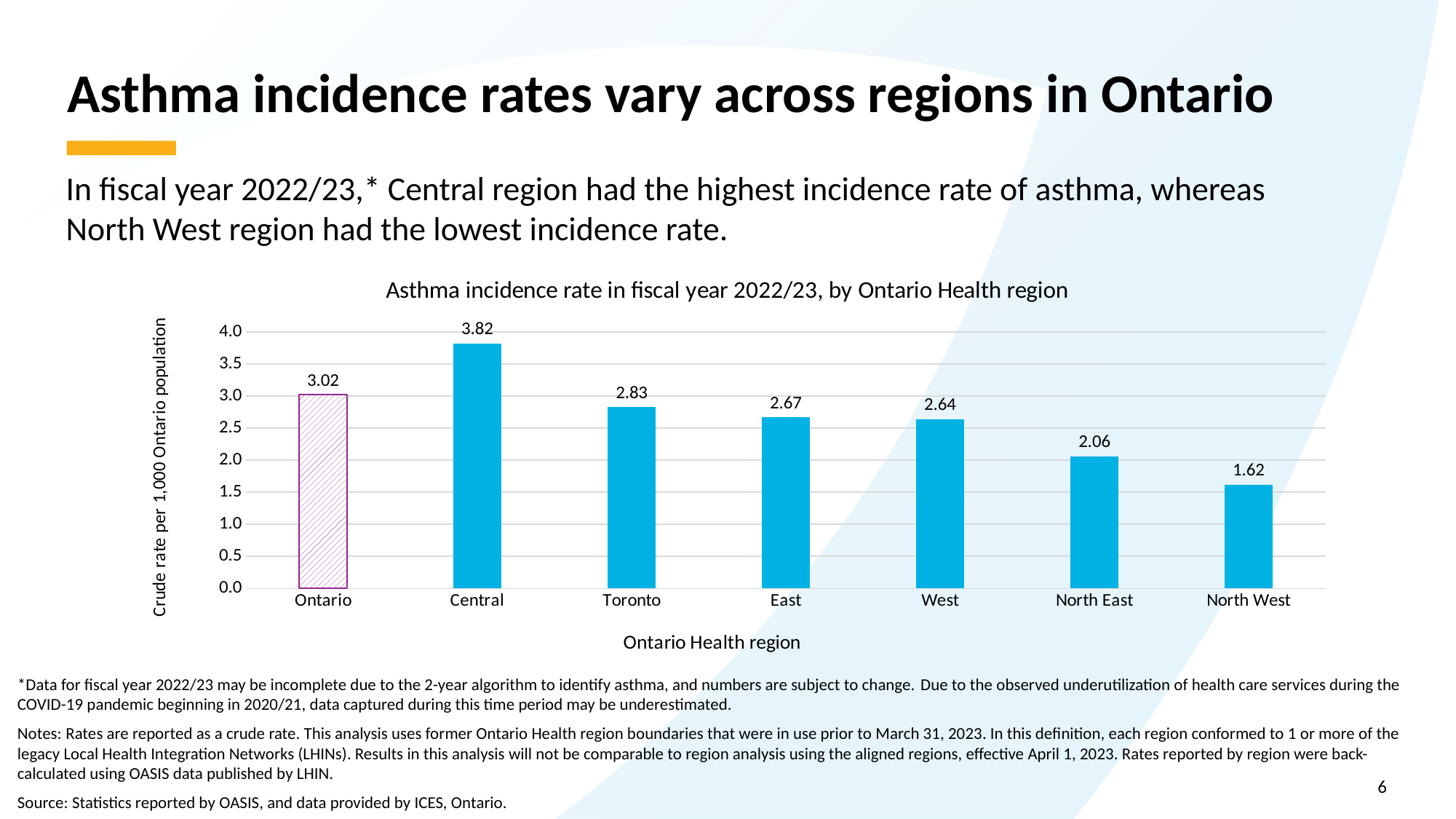
What is the asthma incidence rate for Ontario overall? 3.02 How many bars are shown in the chart? 7 Which region has the highest asthma incidence rate? Central What kind of chart is shown on the slide? Bar chart What is the difference between the asthma incidence rates of Toronto and East? 0.16 Is the value for North East greater or less than 2.5? less What is the asthma incidence rate for North East region? 2.06 What is the asthma incidence rate for Central region? 3.82 What is the title of the chart? Asthma incidence rate in fiscal year 2022/23, by Ontario Health region What is the difference between the asthma incidence rates of Central and North West? 2.20 Which has a higher asthma incidence rate, Toronto or West? Toronto Which region has the lowest asthma incidence rate? North West